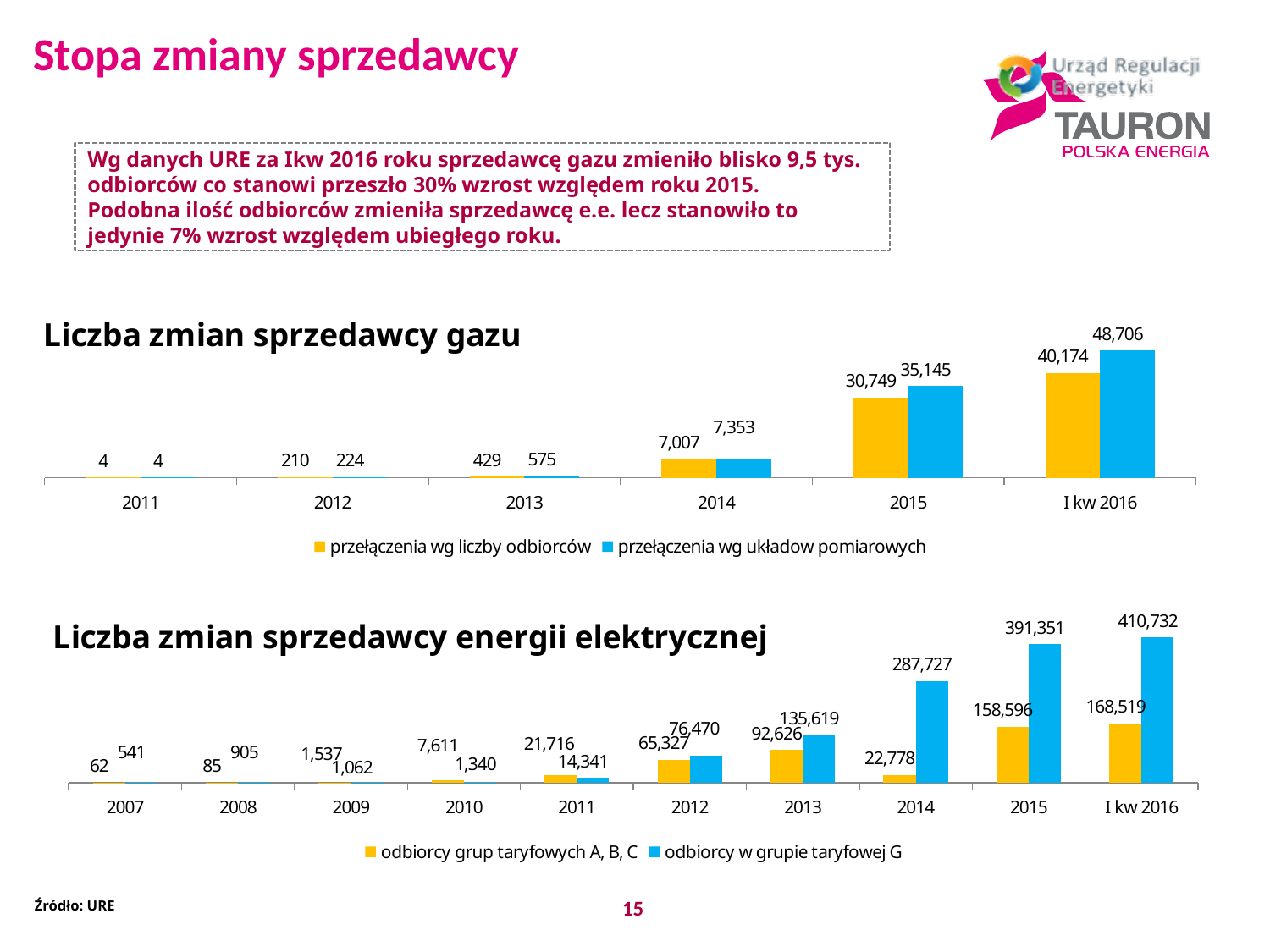
In the chart 'Liczba zmian sprzedawcy energii elektrycznej', which category has the lowest value for 'odbiorcy grup taryfowych A, B, C'? 2007 In the chart 'Liczba zmian sprzedawcy energii elektrycznej', what is the value of 'odbiorcy w grupie taryfowej G' for 2014? 287,727 In the chart 'Liczba zmian sprzedawcy gazu', what is the value of 'przełączenia wg układow pomiarowych' for 2015? 35,145 In the chart 'Liczba zmian sprzedawcy energii elektrycznej', how many series does the legend list? 2 In the chart 'Liczba zmian sprzedawcy gazu', what is the difference between the two series in I kw 2016? 8,532 In the chart 'Liczba zmian sprzedawcy gazu', what is the value of 'przełączenia wg liczby odbiorców' for 2014? 7,007 In the chart 'Liczba zmian sprzedawcy gazu', which category has the highest value for 'przełączenia wg układow pomiarowych'? I kw 2016 In the chart 'Liczba zmian sprzedawcy gazu', do the values of 'przełączenia wg liczby odbiorców' rise or fall from 2011 to I kw 2016? rise What type of chart is 'Liczba zmian sprzedawcy energii elektrycznej'? bar chart In the chart 'Liczba zmian sprzedawcy energii elektrycznej', which is larger in 2010: 'odbiorcy grup taryfowych A, B, C' or 'odbiorcy w grupie taryfowej G'? odbiorcy grup taryfowych A, B, C In the chart 'Liczba zmian sprzedawcy gazu', how many categories are shown on the x axis? 6 In the chart 'Liczba zmian sprzedawcy energii elektrycznej', what is the value of 'odbiorcy grup taryfowych A, B, C' for 2013? 92,626